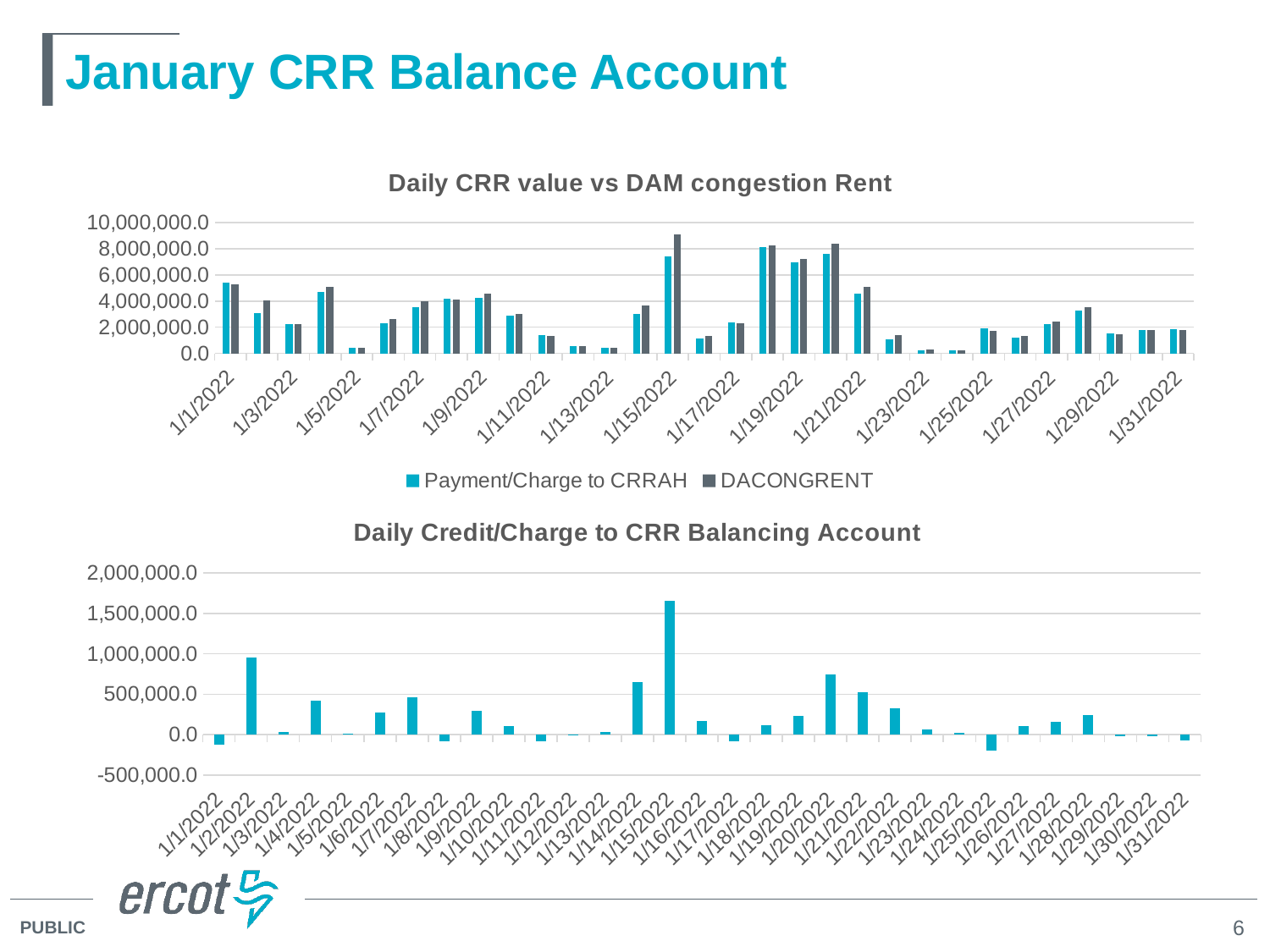
In the top chart, 'Daily CRR value vs DAM congestion Rent', is the DACONGRENT value for 1/15/2022 greater or less than 8,000,000.0? greater What kind of chart is the bottom chart, 'Daily Credit/Charge to CRR Balancing Account'? bar chart In the bottom chart, 'Daily Credit/Charge to CRR Balancing Account', is the value for 1/15/2022 greater or less than 1,500,000.0? greater In the bottom chart, 'Daily Credit/Charge to CRR Balancing Account', which date has the lowest value? 1/25/2022 In the bottom chart, 'Daily Credit/Charge to CRR Balancing Account', how many dates are plotted? 31 In the top chart, 'Daily CRR value vs DAM congestion Rent', on 1/15/2022 which series is larger, Payment/Charge to CRRAH or DACONGRENT? DACONGRENT In the top chart, 'Daily CRR value vs DAM congestion Rent', how many series does the legend list? 2 In the top chart, 'Daily CRR value vs DAM congestion Rent', which date has the highest DACONGRENT value? 1/15/2022 In the bottom chart, 'Daily Credit/Charge to CRR Balancing Account', which is larger, the value for 1/2/2022 or the value for 1/4/2022? 1/2/2022 In the bottom chart, 'Daily Credit/Charge to CRR Balancing Account', which date has the highest value? 1/15/2022 In the bottom chart, 'Daily Credit/Charge to CRR Balancing Account', is the value for 1/2/2022 greater or less than 1,000,000.0? less In the top chart, 'Daily CRR value vs DAM congestion Rent', which colour represents the Payment/Charge to CRRAH series? teal (blue)